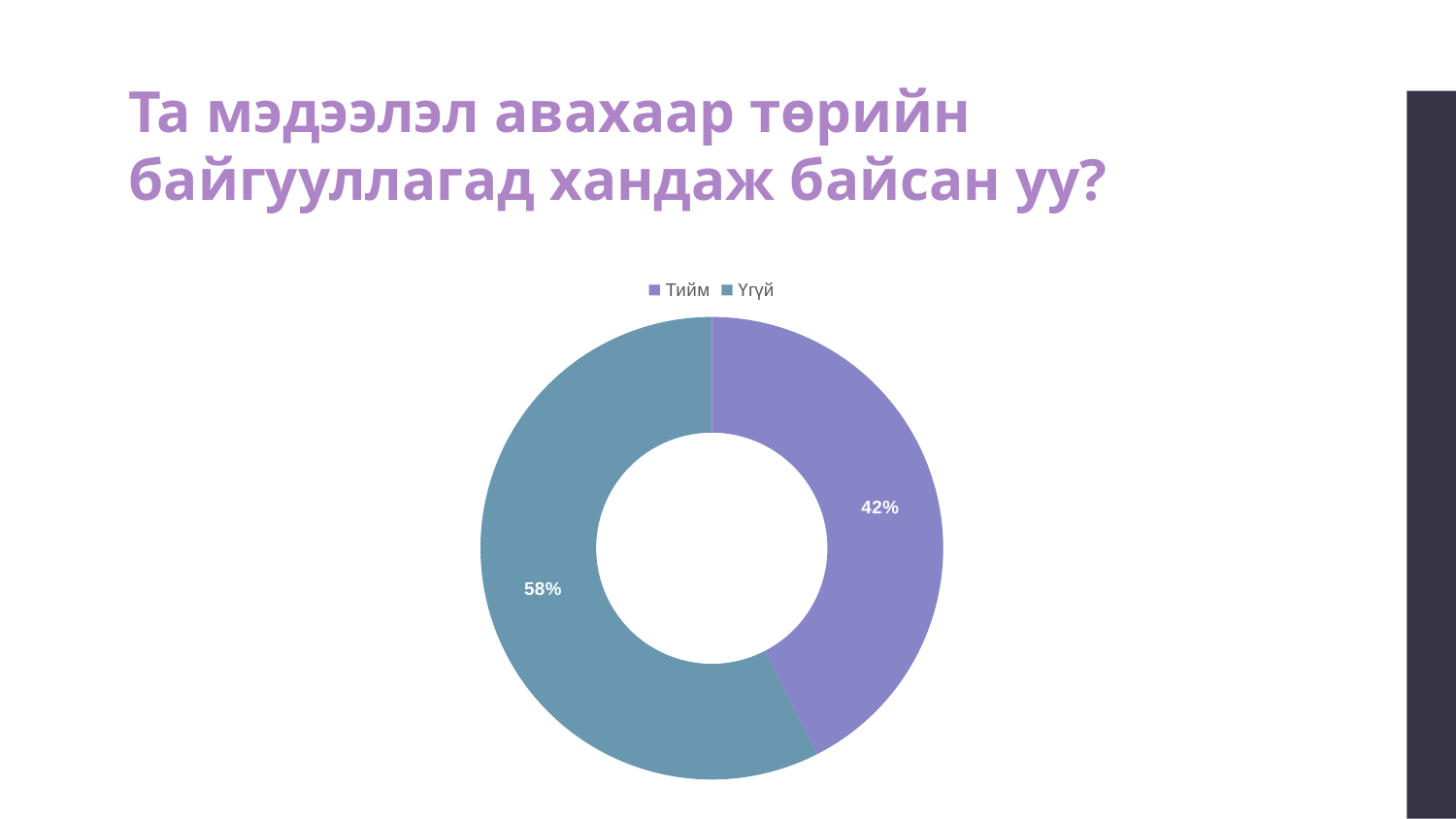
What is the difference in percentage points between Үгүй and Тийм? 16 How many categories does the chart show? 2 Which category has the largest share of the chart? Үгүй What is the title of the slide above the chart? Та мэдээлэл авахаар төрийн байгууллагад хандаж байсан уу? What colour is the Үгүй slice? Teal (blue-grey) Is the share for Тийм greater or less than 50%? less How many entries does the legend list? 2 Which category has the smallest share of the chart? Тийм What percentage is shown for Тийм? 42% What kind of chart is shown on the slide? Doughnut (pie) chart What percentage is shown for Үгүй? 58% Which category has the larger share, Тийм or Үгүй? Үгүй